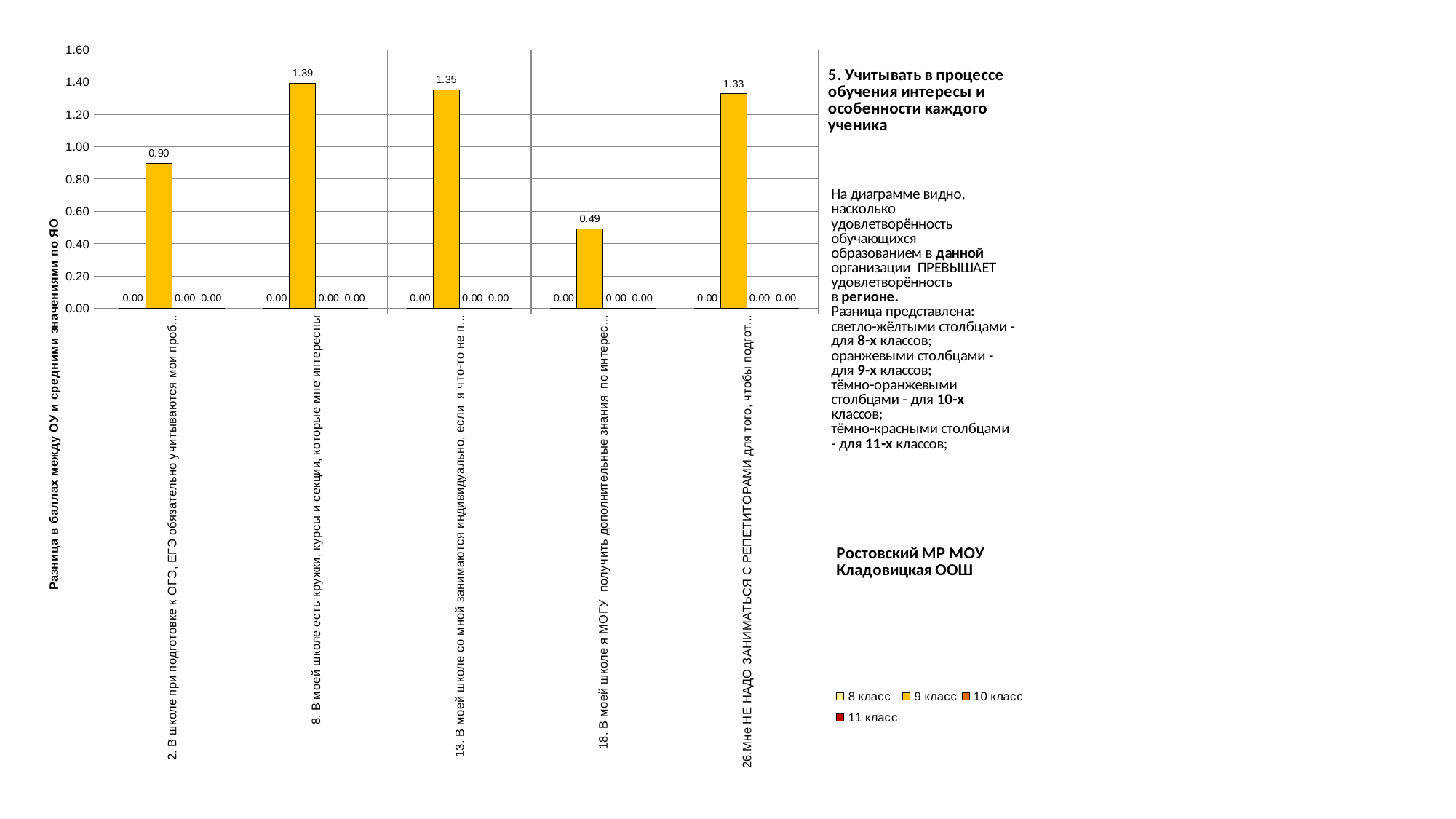
What is the value for the 9 класс series in the category beginning "2. В школе при подготовке к ОГЭ, ЕГЭ..."? 0.90 What kind of chart is shown on the slide? bar chart Which is larger for the 9 класс series: the value for category 13 or the value for category 26? category 13 (1.35) What is the value for the 9 класс series in the category beginning "18. В моей школе я МОГУ получить дополнительные знания..."? 0.49 What is the value for the 8 класс series in the category beginning "13. В моей школе со мной занимаются индивидуально..."? 0.00 What is the difference between the 9 класс values for category 8 (1.39) and category 2 (0.90)? 0.49 How many categories are shown on the x axis of the chart? 5 Which category has the highest value for the 9 класс series? 8. В моей школе есть кружки, курсы и секции, которые мне интересны Is the 9 класс value for the category beginning "2. В школе при подготовке к ОГЭ, ЕГЭ..." greater or less than 1.00? less What is the value for the 9 класс series in the category "8. В моей школе есть кружки, курсы и секции, которые мне интересны"? 1.39 How many series does the chart legend list? 4 Which category has the lowest value for the 9 класс series? 18. В моей школе я МОГУ получить дополнительные знания по интерес...